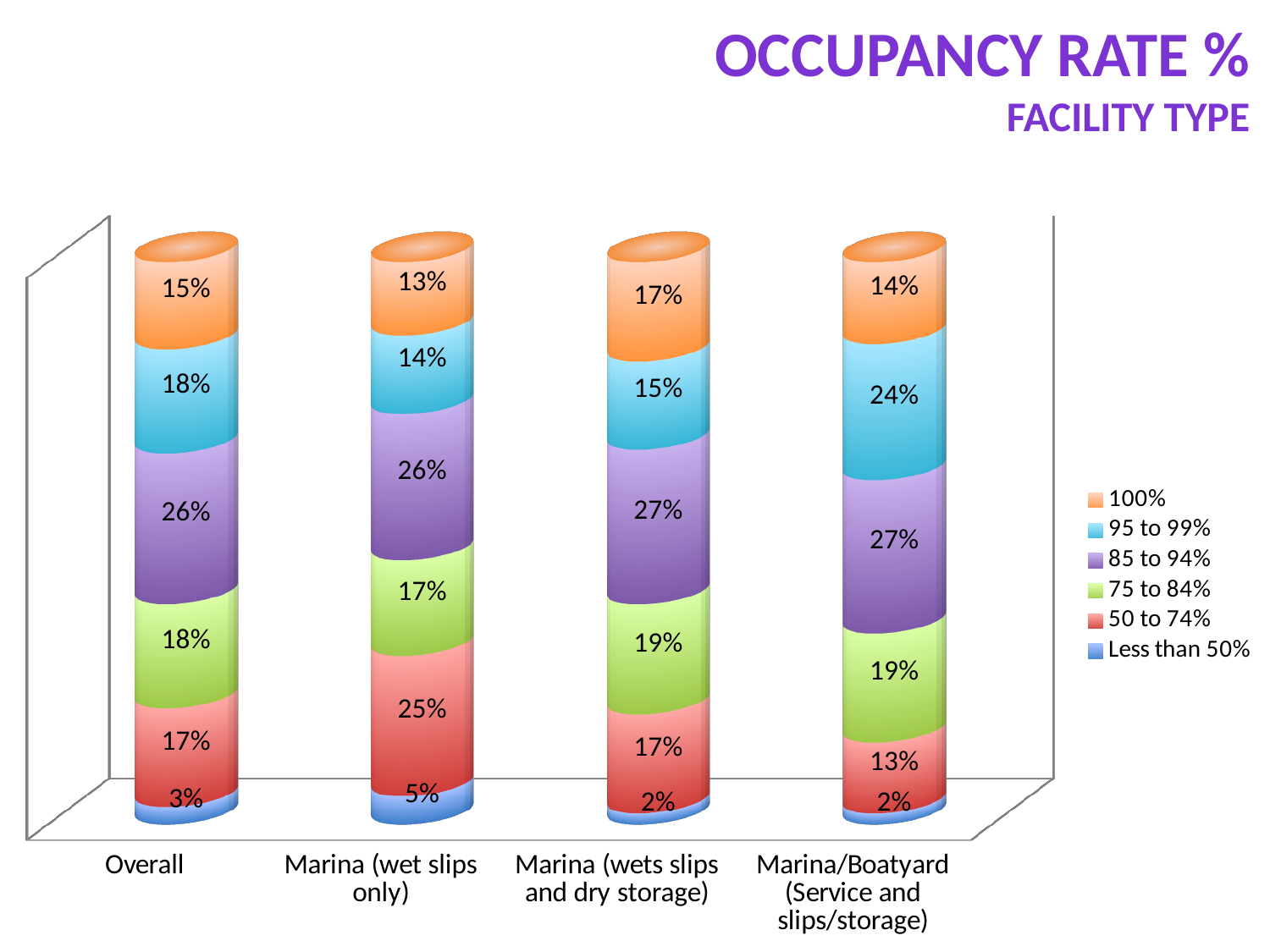
What is the difference between the 50 to 74% values for Marina (wet slips only) and Marina/Boatyard (Service and slips/storage)? 12 percentage points What kind of chart is shown on the slide? Stacked bar chart What is the value of the 50 to 74% segment for Marina (wet slips only)? 25% What is the value of the 85 to 94% segment for Overall? 26% Which occupancy range is the largest segment in the Overall bar? 85 to 94% What is the value of the Less than 50% segment for Marina (wets slips and dry storage)? 2% How many facility type categories are shown on the x axis? 4 Which facility type has the lowest value for the 50 to 74% segment? Marina/Boatyard (Service and slips/storage) How many series does the legend list? 6 Which facility type has the highest value for the 95 to 99% segment? Marina/Boatyard (Service and slips/storage) Which has the larger 100% segment: Overall or Marina (wets slips and dry storage)? Marina (wets slips and dry storage) What is the value of the 95 to 99% segment for Marina/Boatyard (Service and slips/storage)? 24%